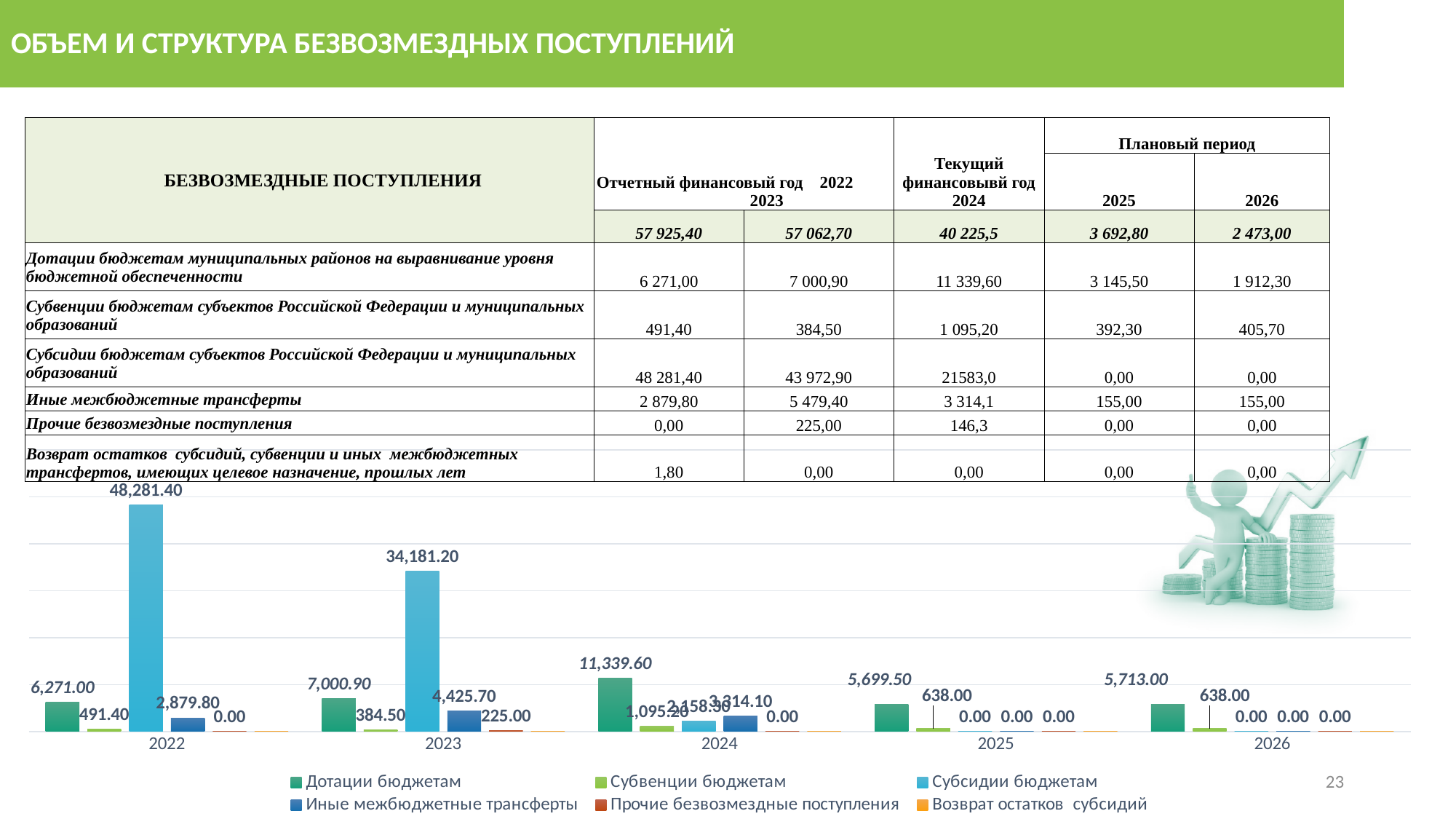
How many years are shown on the x axis of the chart? 5 What kind of chart is shown at the bottom of the slide? Bar chart In the chart, is the Дотации бюджетам value larger in 2022 or in 2023? 2023 In the chart, what is the value of Субсидии бюджетам for 2022? 48,281.40 How many series does the chart legend list? 6 In the chart, what is the value of Иные межбюджетные трансферты for 2023? 4,425.70 In the chart, what is the value of Дотации бюджетам for 2024? 11,339.60 In the chart, what is the difference between the Субсидии бюджетам values for 2022 and 2023? 14,100.20 In the chart, what is the value of Субвенции бюджетам for 2025? 638.00 In the chart, what is the value of Прочие безвозмездные поступления for 2023? 225.00 In the chart, do the Субсидии бюджетам values rise or fall from 2022 to 2026? Fall In the chart, which year has the highest value for Субсидии бюджетам? 2022